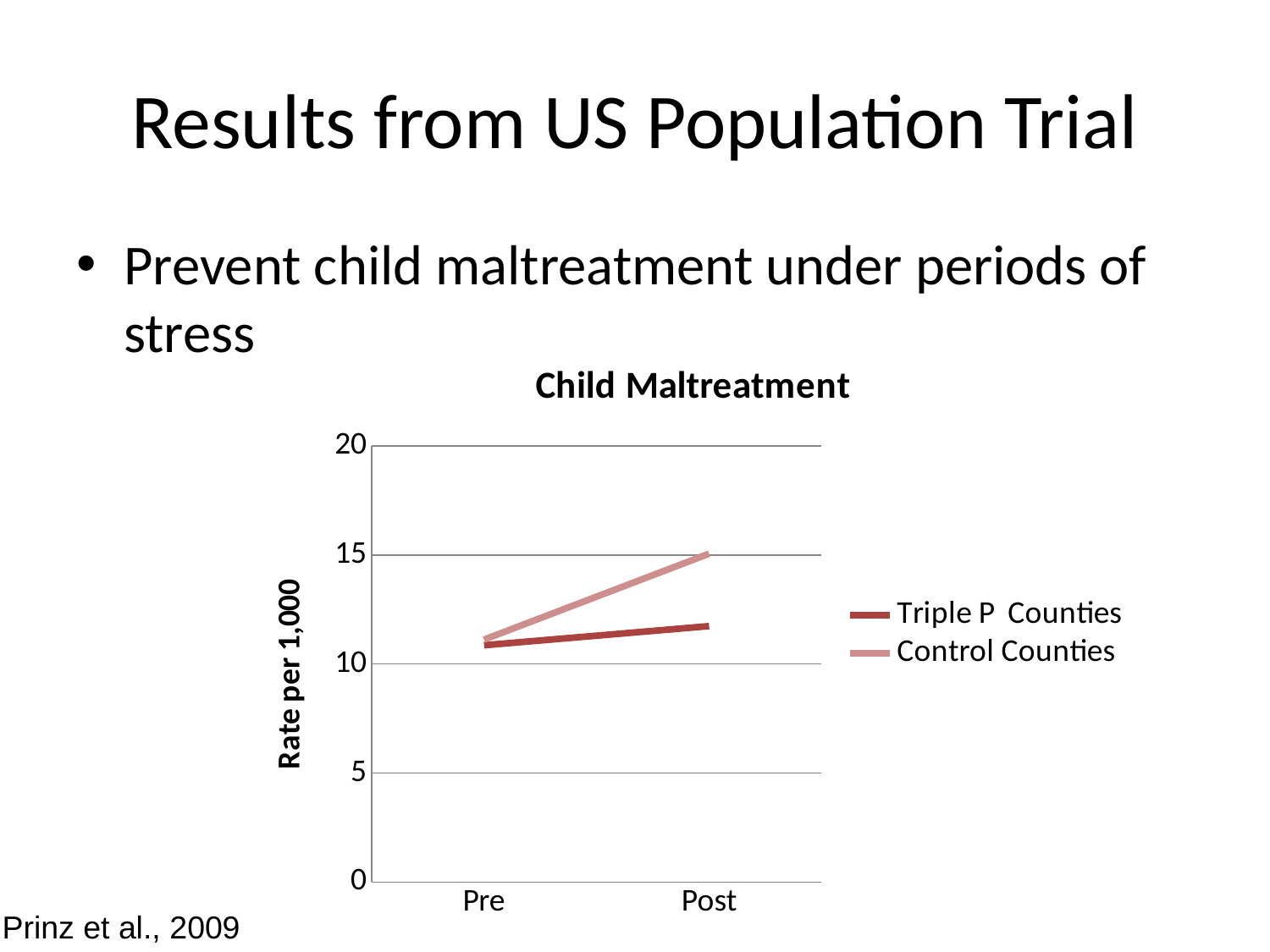
Is the Post value for Control Counties greater or less than 10? greater Does the Control Counties line rise or fall from Pre to Post? rise What kind of chart is shown on the slide? line chart Is the Post value for Triple P Counties greater or less than 15? less Is the Post value for Control Counties greater or less than 20? less What is the title of the chart on the slide? Child Maltreatment How many series does the legend of the Child Maltreatment chart list? 2 What is the label on the vertical axis of the chart? Rate per 1,000 At Post, which series has the higher value, Triple P Counties or Control Counties? Control Counties How many categories are shown on the x axis of the Child Maltreatment chart? 2 Does the Triple P Counties line rise or fall from Pre to Post? rise